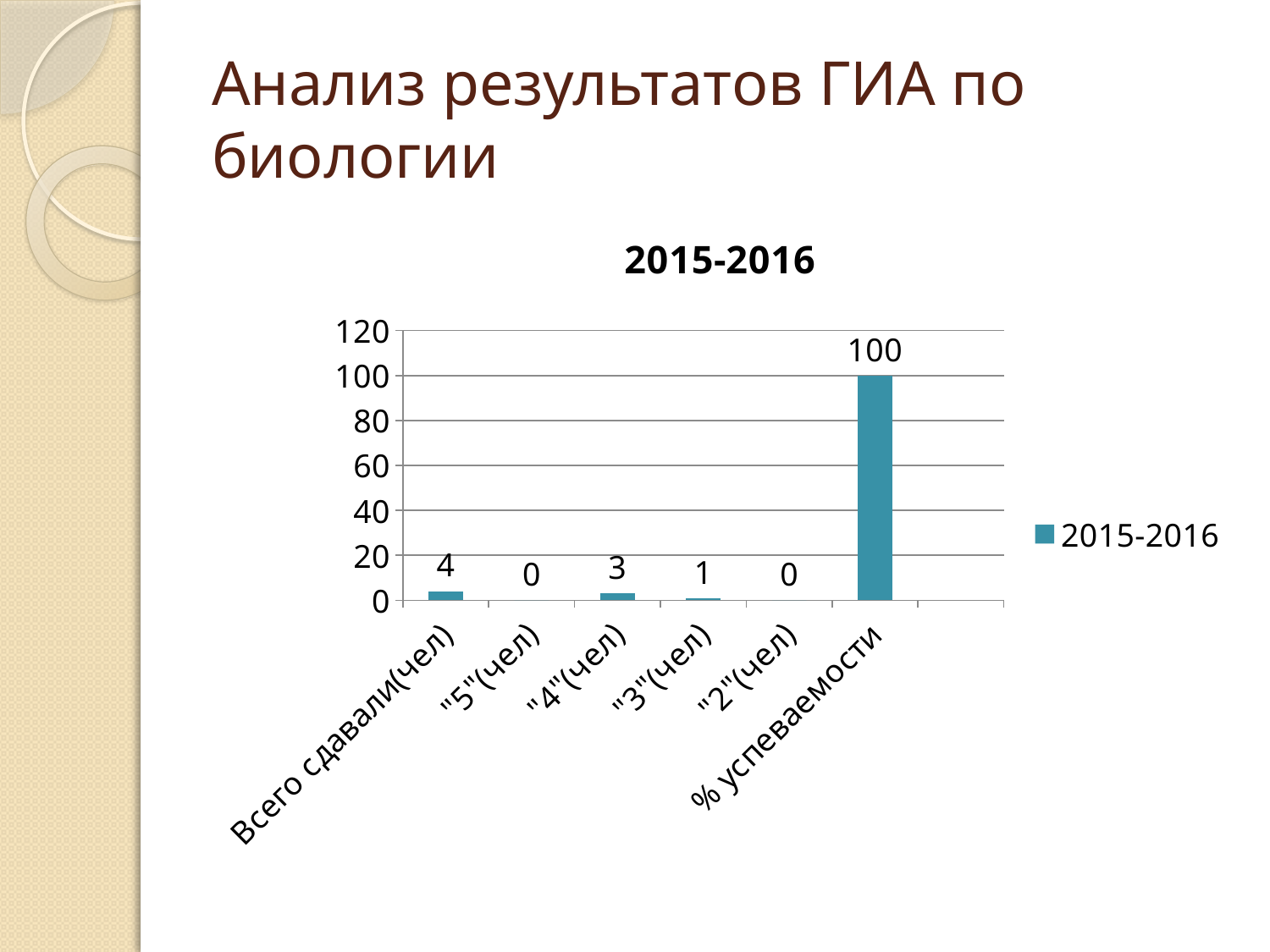
What is the difference between the values for "Всего сдавали(чел)" and "4"(чел)? 1 What kind of chart is shown on the slide? bar chart How many series does the legend list? 1 Which category has the highest value? % успеваемости Which is larger, the value for "4"(чел) or the value for "3"(чел)? "4"(чел) What is the value for "5"(чел)? 0 What is the value for "% успеваемости"? 100 How many categories are shown on the x axis? 6 Is the value for "% успеваемости" greater or less than 80? greater What is the value for "3"(чел)? 1 What is the value for "Всего сдавали(чел)"? 4 What is the value for "4"(чел)? 3